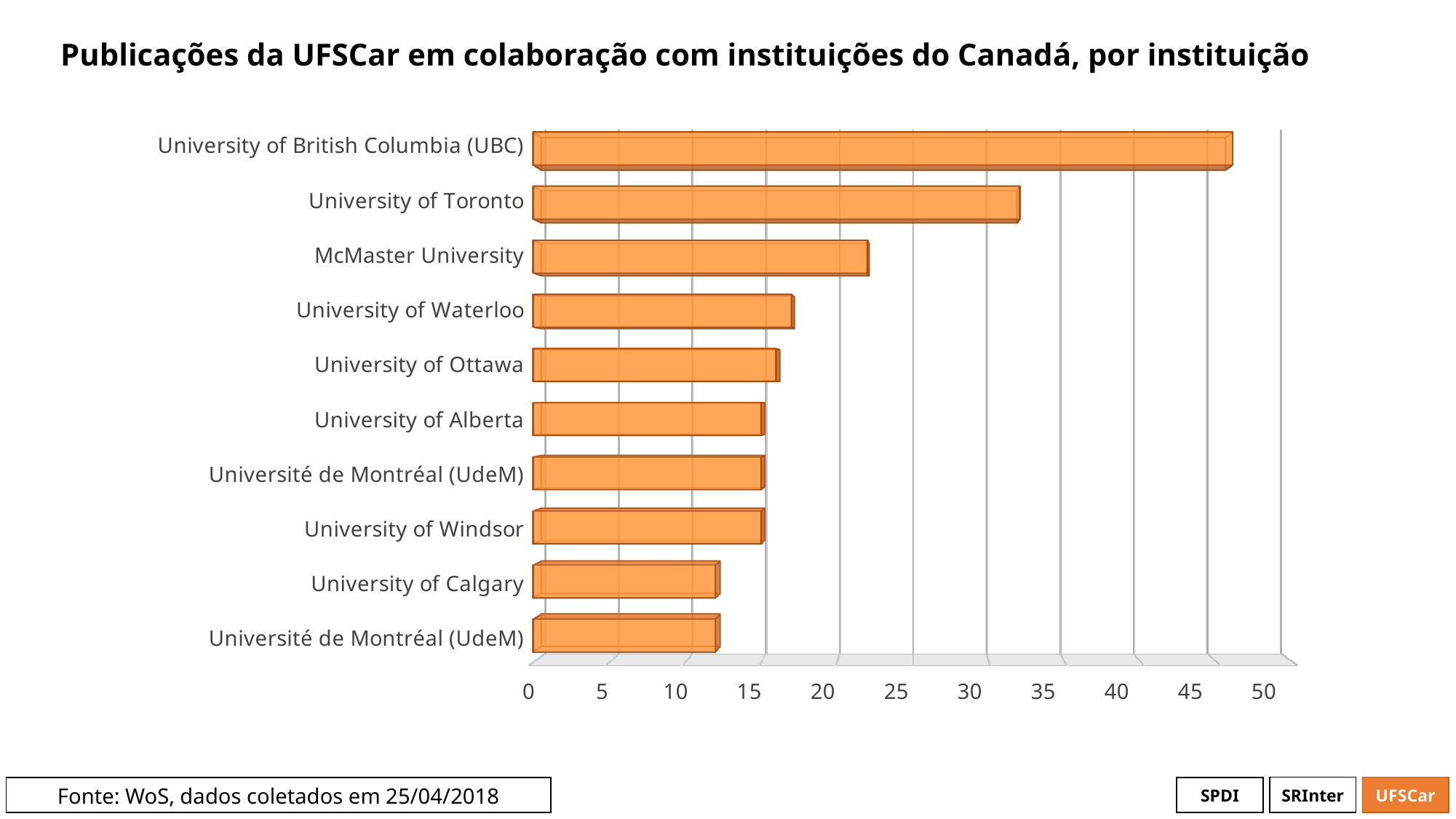
Is the value for University of Toronto greater or less than 30? greater What is the title of the chart? Publicações da UFSCar em colaboração com instituições do Canadá, por instituição How many institutions are listed on the chart? 10 Which has more publications, University of Waterloo or University of Calgary? University of Waterloo Is the value for McMaster University greater or less than 20? greater Is the value for University of Waterloo greater or less than 20? less What kind of chart is shown on the slide? bar chart Which has more publications, University of Toronto or McMaster University? University of Toronto Which institution has the highest number of publications in collaboration with UFSCar? University of British Columbia (UBC)